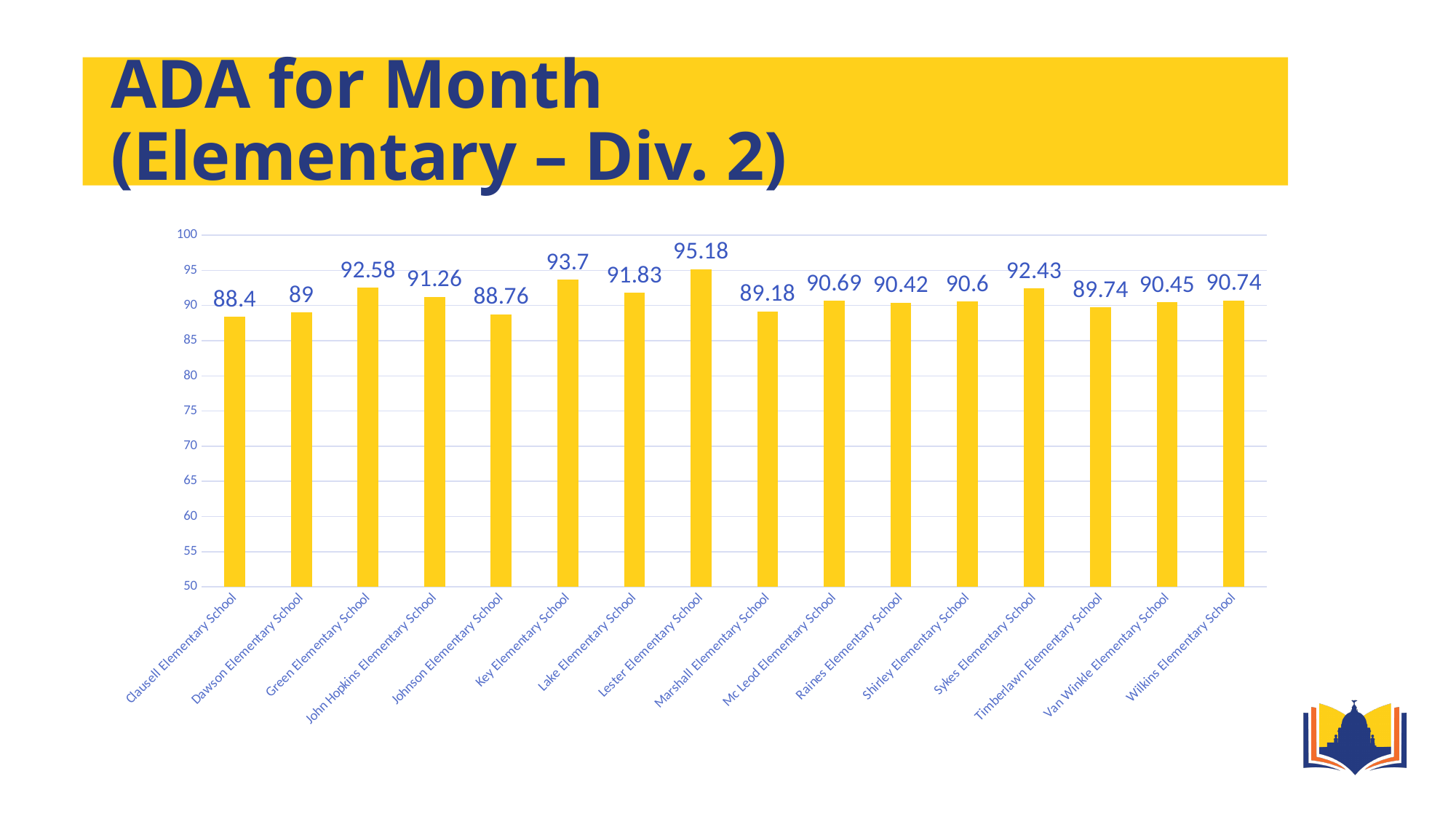
What is the difference between the ADA values of Key Elementary School and Green Elementary School? 1.12 Which has a higher ADA, Sykes Elementary School or Marshall Elementary School? Sykes Elementary School What is the difference between the ADA values of Lester Elementary School and Clausell Elementary School? 6.78 What is the ADA value for Key Elementary School? 93.7 Which school has the highest ADA for the month? Lester Elementary School Which school has the lowest ADA for the month? Clausell Elementary School Is the ADA value for Johnson Elementary School greater or less than 90? less What is the ADA value for Timberlawn Elementary School? 89.74 What is the title of the slide? ADA for Month (Elementary – Div. 2) What is the ADA value for Lester Elementary School? 95.18 How many schools are shown in the chart? 16 What type of chart is shown on the slide? Bar chart